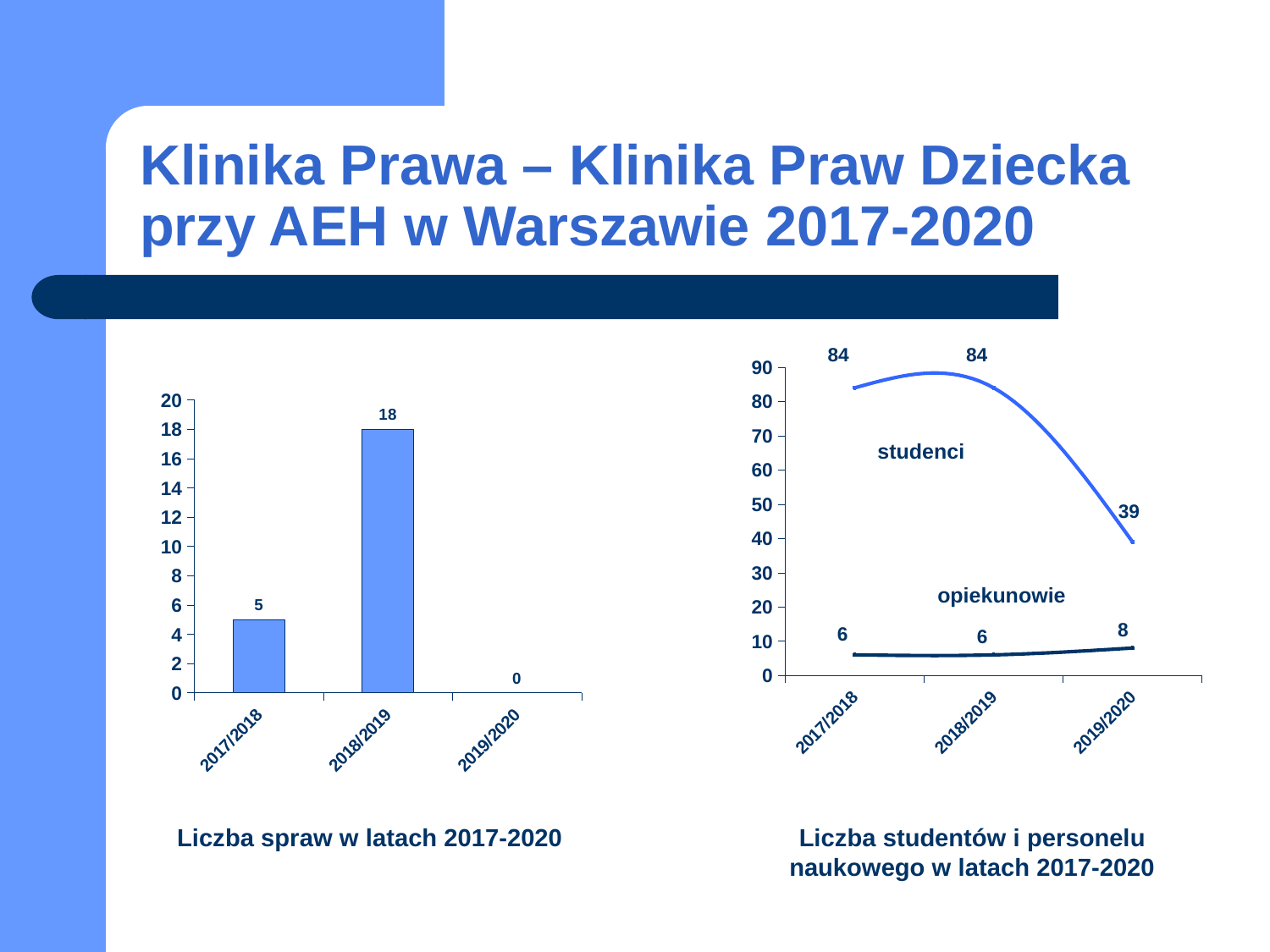
In the left chart (Liczba spraw w latach 2017-2020), which category has the highest value? 2018/2019 In the left chart (Liczba spraw w latach 2017-2020), how many categories are shown on the x axis? 3 What kind of chart is the left chart (Liczba spraw w latach 2017-2020)? bar chart In the right chart (Liczba studentów i personelu naukowego w latach 2017-2020), what is the difference between studenci and opiekunowie in 2017/2018? 78 In the right chart (Liczba studentów i personelu naukowego w latach 2017-2020), what is the value for studenci in 2019/2020? 39 What kind of chart is the right chart (Liczba studentów i personelu naukowego w latach 2017-2020)? line chart In the right chart (Liczba studentów i personelu naukowego w latach 2017-2020), what is the value for opiekunowie in 2019/2020? 8 In the left chart (Liczba spraw w latach 2017-2020), which category has the lowest value? 2019/2020 In the right chart (Liczba studentów i personelu naukowego w latach 2017-2020), does the studenci series rise or fall from 2018/2019 to 2019/2020? fall In the left chart (Liczba spraw w latach 2017-2020), what is the value for 2018/2019? 18 In the left chart (Liczba spraw w latach 2017-2020), what is the difference between the values for 2018/2019 and 2017/2018? 13 In the right chart (Liczba studentów i personelu naukowego w latach 2017-2020), is the value for studenci in 2019/2020 greater or less than 50? less